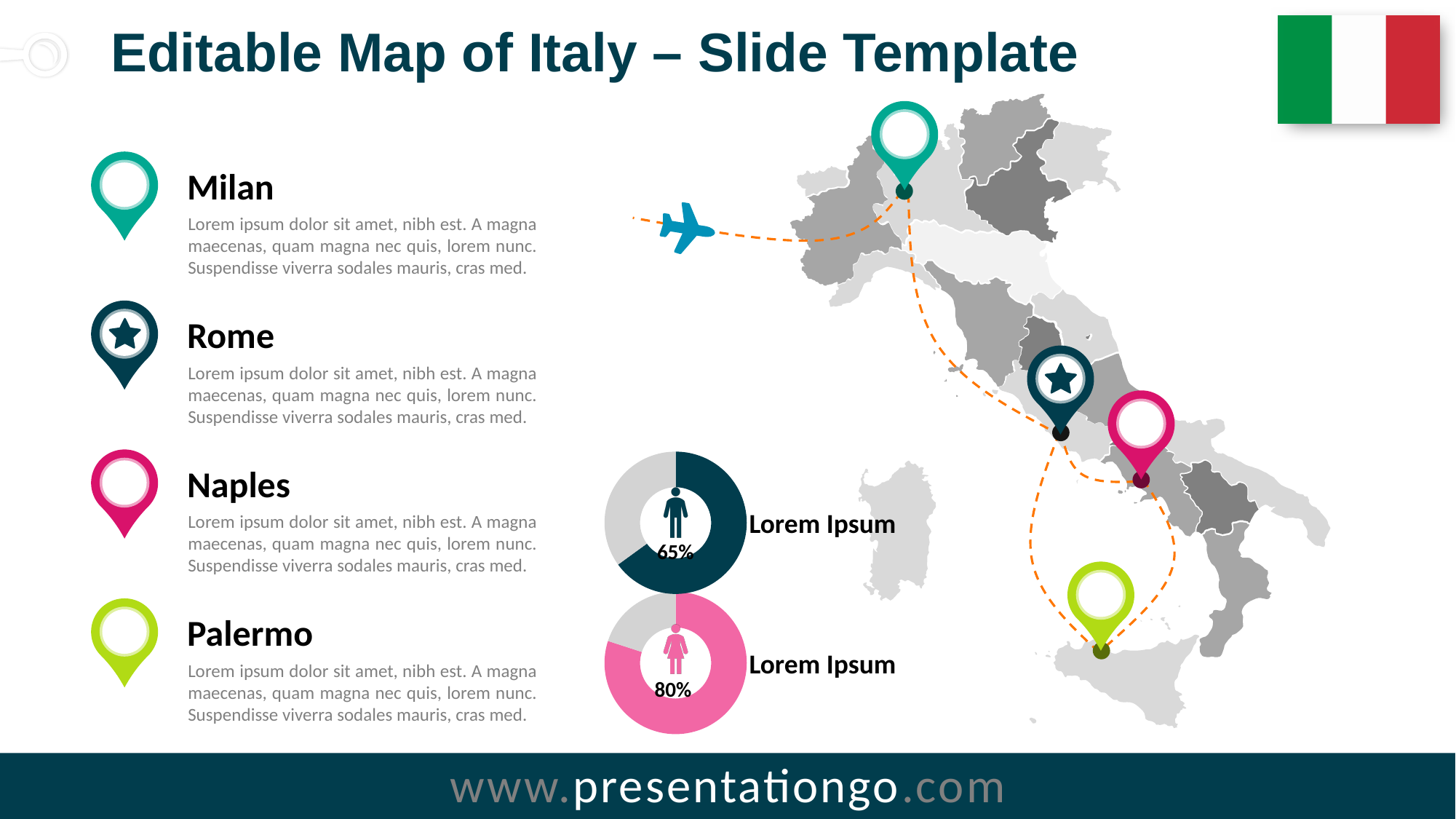
In the lower donut chart with the female figure icon, what percentage is shown? 80% In the lower donut chart with the female icon, what share of the ring is left unfilled (grey)? 20% In the upper donut chart with the male figure icon, what percentage is shown? 65% What label text appears to the right of each donut chart? Lorem Ipsum How many donut charts are shown on the slide? 2 What is the difference between the percentage in the lower donut chart (female icon) and the upper donut chart (male icon)? 15 percentage points What kind of chart is used to display the 65% and 80% values on the slide? Donut (pie) chart What colour is the filled portion of the lower donut chart with the female icon? Pink Which donut chart shows the larger percentage, the upper one with the male icon or the lower one with the female icon? The lower one with the female icon Is the value shown in the upper donut chart with the male icon greater or less than 50%? greater In the upper donut chart with the male icon, what share of the ring is left unfilled (grey)? 35%